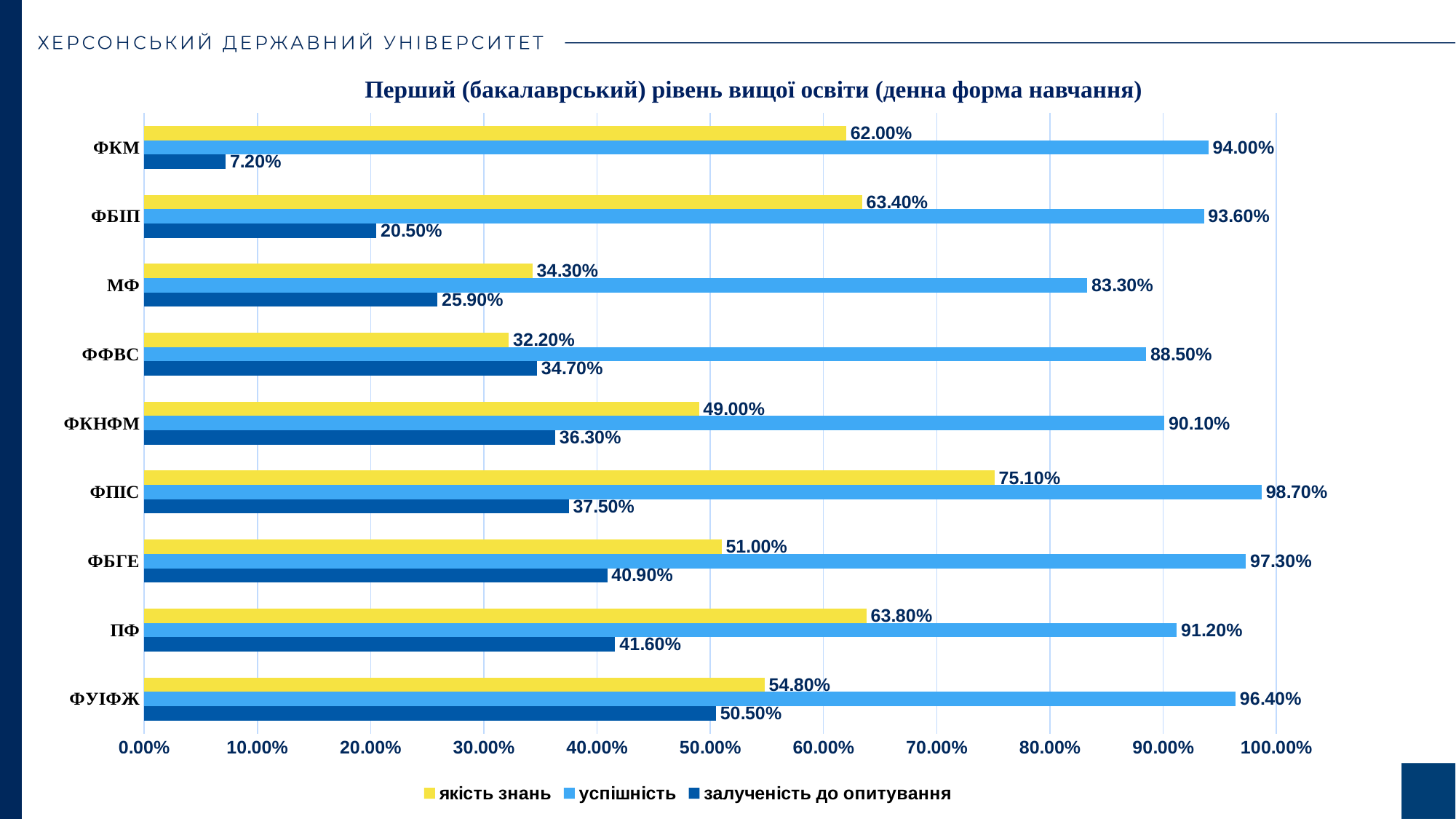
Which faculty has the lowest якість знань value? ФФВС Which faculty has the highest успішність value? ФПІС Which faculty has the lowest залученість до опитування value? ФКМ What kind of chart is shown on the slide? Bar chart How many faculties are shown on the chart? 9 Which is larger: the якість знань value for ПФ or for ФБІП? ПФ What is the залученість до опитування value for ФКМ? 7.20% What is the title of the chart? Перший (бакалаврський) рівень вищої освіти (денна форма навчання) What is the успішність value for МФ? 83.30% How many series does the legend list? 3 What is the difference between the успішність and якість знань values for ФКМ? 32.00% What is the якість знань value for ФПІС? 75.10%